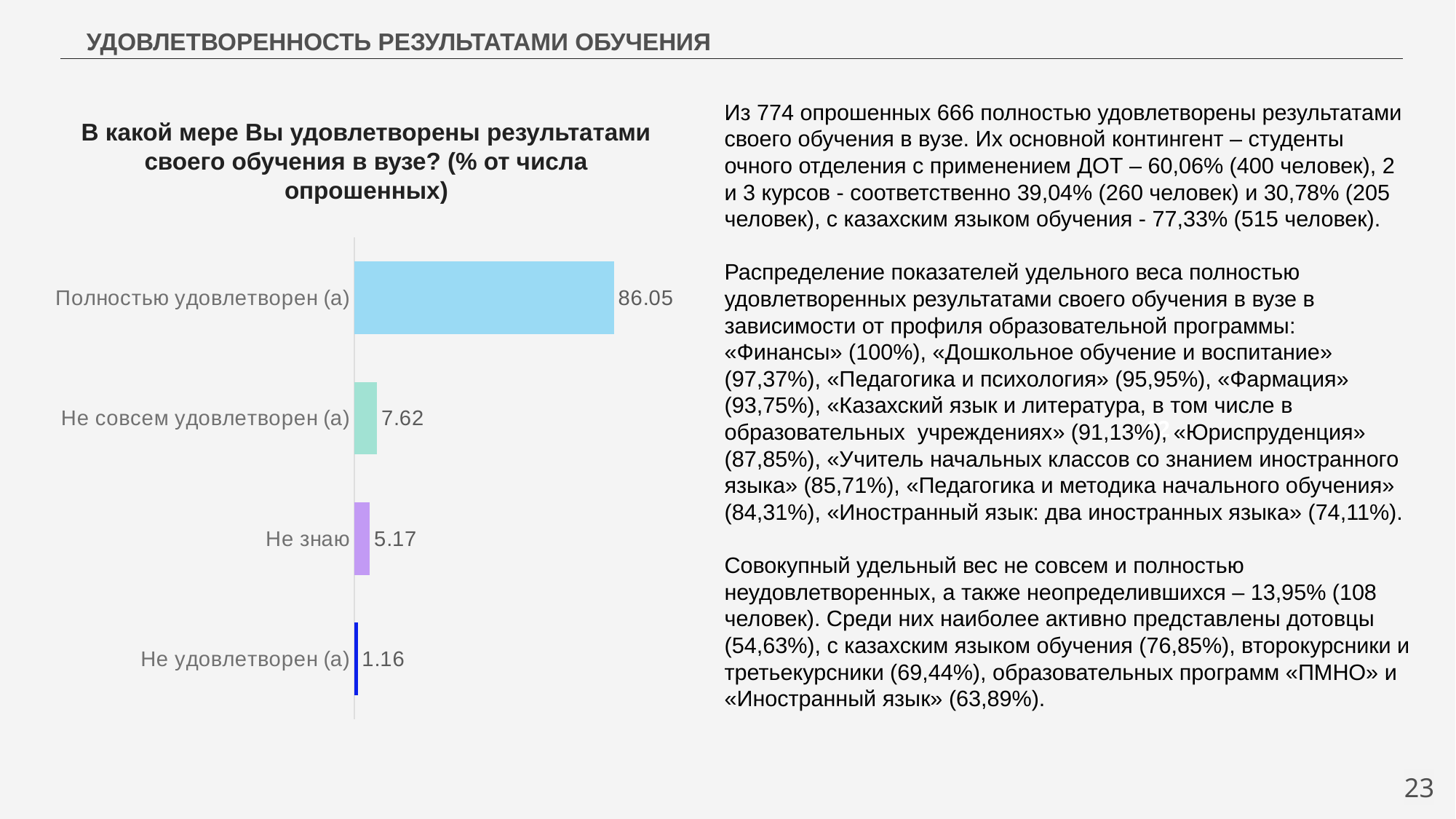
Which is larger, the value for "Не знаю" or the value for "Не удовлетворен (а)"? Не знаю What is the title of the chart? В какой мере Вы удовлетворены результатами своего обучения в вузе? (% от числа опрошенных) What is the difference between the values for "Не совсем удовлетворен (а)" and "Не знаю"? 2.45 How many categories are shown in the chart? 4 Which category has the highest value? Полностью удовлетворен (а) What is the value for "Полностью удовлетворен (а)"? 86.05 What is the value for "Не совсем удовлетворен (а)"? 7.62 What is the value for "Не удовлетворен (а)"? 1.16 What kind of chart is shown on the slide? Bar chart Which category has the lowest value? Не удовлетворен (а) What is the value for "Не знаю"? 5.17 What is the difference between the values for "Полностью удовлетворен (а)" and "Не совсем удовлетворен (а)"? 78.43